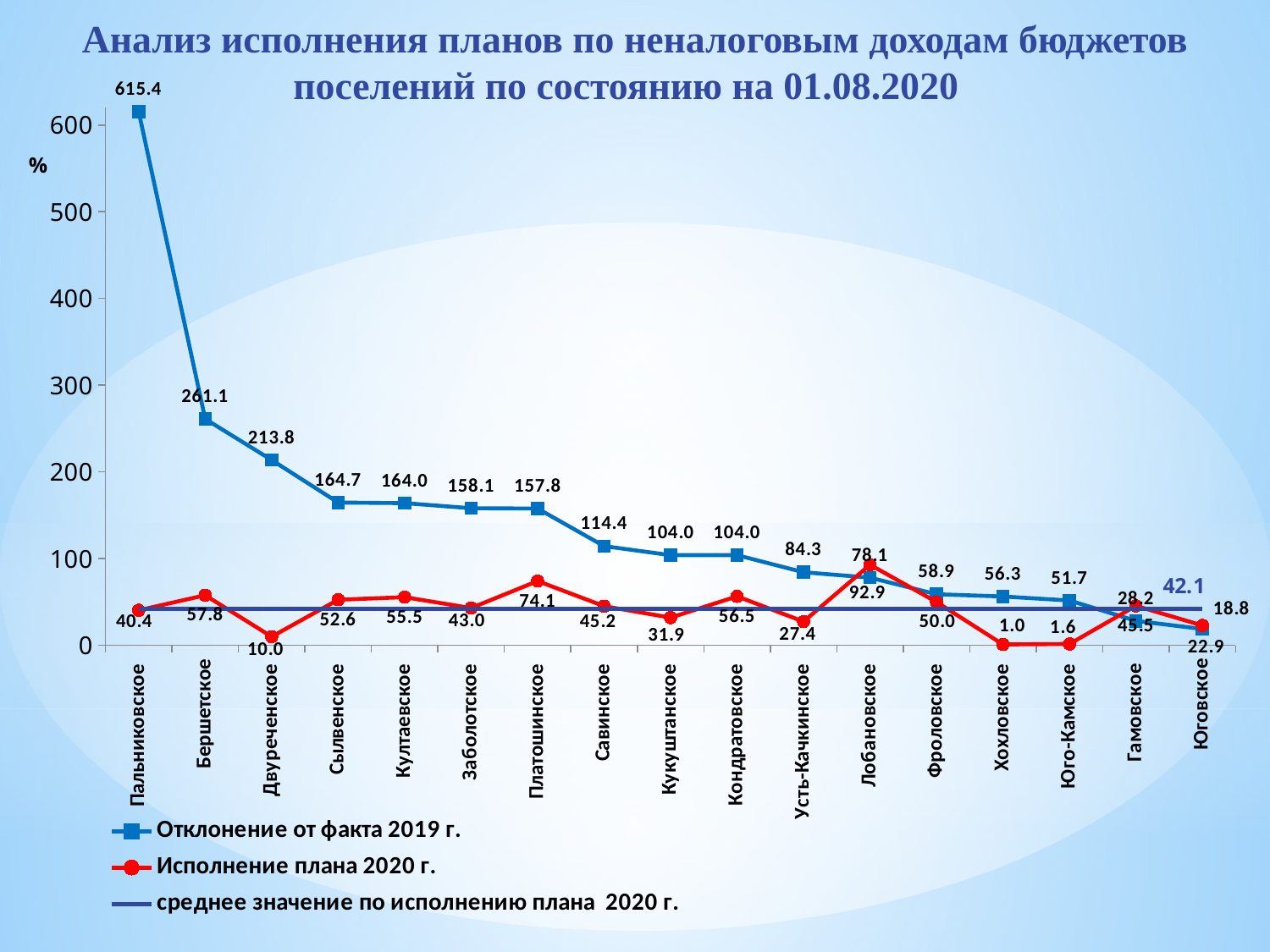
What is the value of the average line 'среднее значение по исполнению плана 2020 г.'? 42.1 What is the value of 'Исполнение плана 2020 г.' for Усть-Качкинское? 27.4 What kind of chart is shown on the slide? line chart What is the difference between the 'Отклонение от факта 2019 г.' values for Бершетское and Двуреченское? 47.3 How many settlements (categories) are plotted along the x axis? 17 How many series does the legend list? 3 What is the value of 'Отклонение от факта 2019 г.' for Пальниковское? 615.4 Is the 'Отклонение от факта 2019 г.' value for Савинское greater or less than 100? greater Which settlement has the highest value for 'Отклонение от факта 2019 г.'? Пальниковское What is the value of 'Исполнение плана 2020 г.' for Двуреченское? 10.0 For 'Исполнение плана 2020 г.', which is larger: Платошинское or Сылвенское? Платошинское Which settlement has the highest value for 'Исполнение плана 2020 г.'? Лобановское